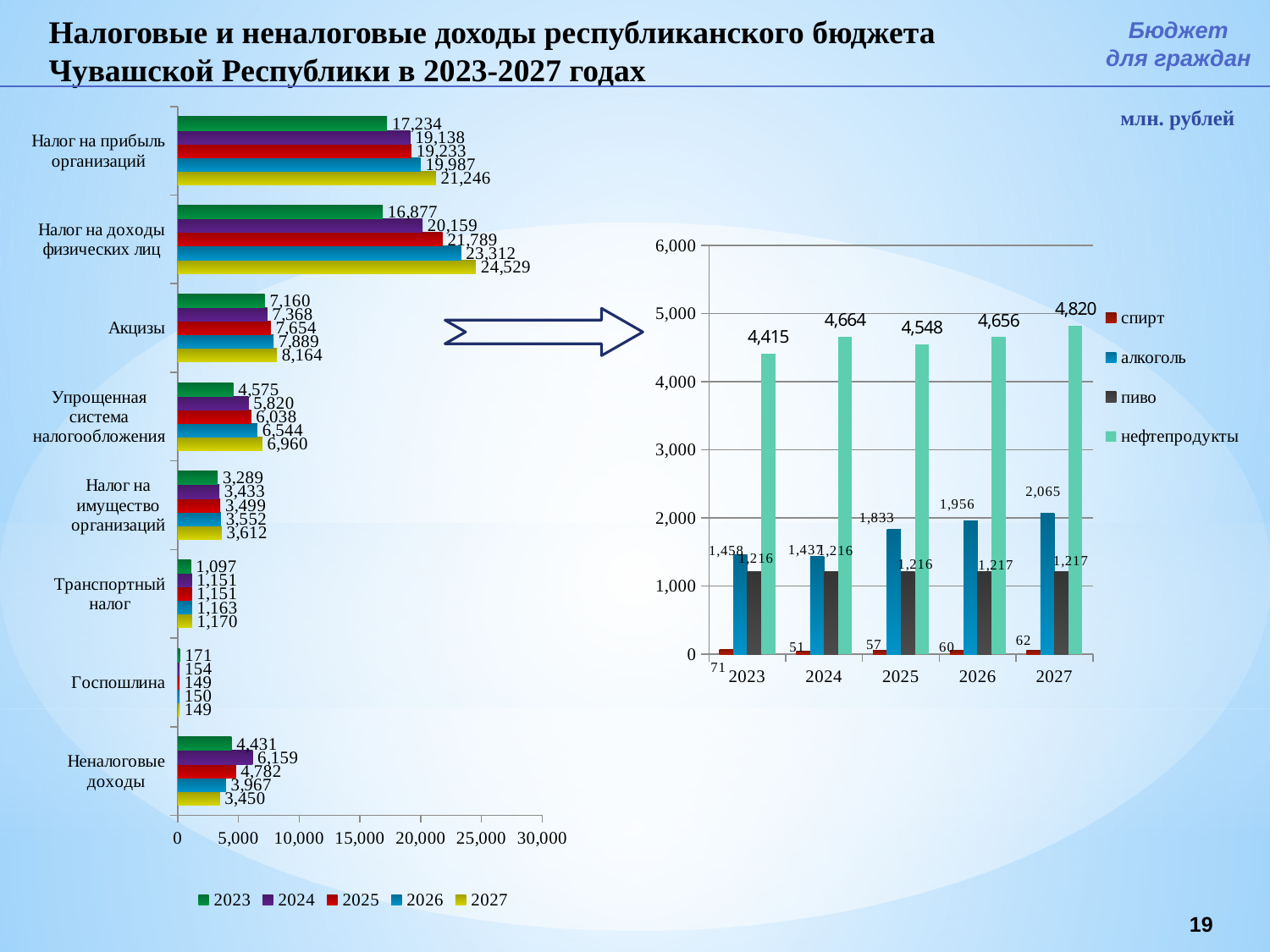
On the left chart, which category has the highest value in 2027? Налог на доходы физических лиц On the left chart, how many categories are shown? 8 On the left chart, how many series does the legend list? 5 On the right chart, which is larger in 2026: алкоголь or пиво? алкоголь On the left chart, what is the difference between the 2027 and 2023 values for Акцизы? 1,004 On the left chart, what is the value for Налог на доходы физических лиц in 2023? 16,877 On the left chart, do the values for Налог на доходы физических лиц rise or fall from 2023 to 2027? rise On the left chart, which category has the lowest value in 2023? Госпошлина On the right chart, what is the value for алкоголь in 2025? 1,833 On the left chart, what is the value for Налог на прибыль организаций in 2027? 21,246 On the right chart, what is the value for нефтепродукты in 2027? 4,820 On the right chart, how many series does the legend list? 4